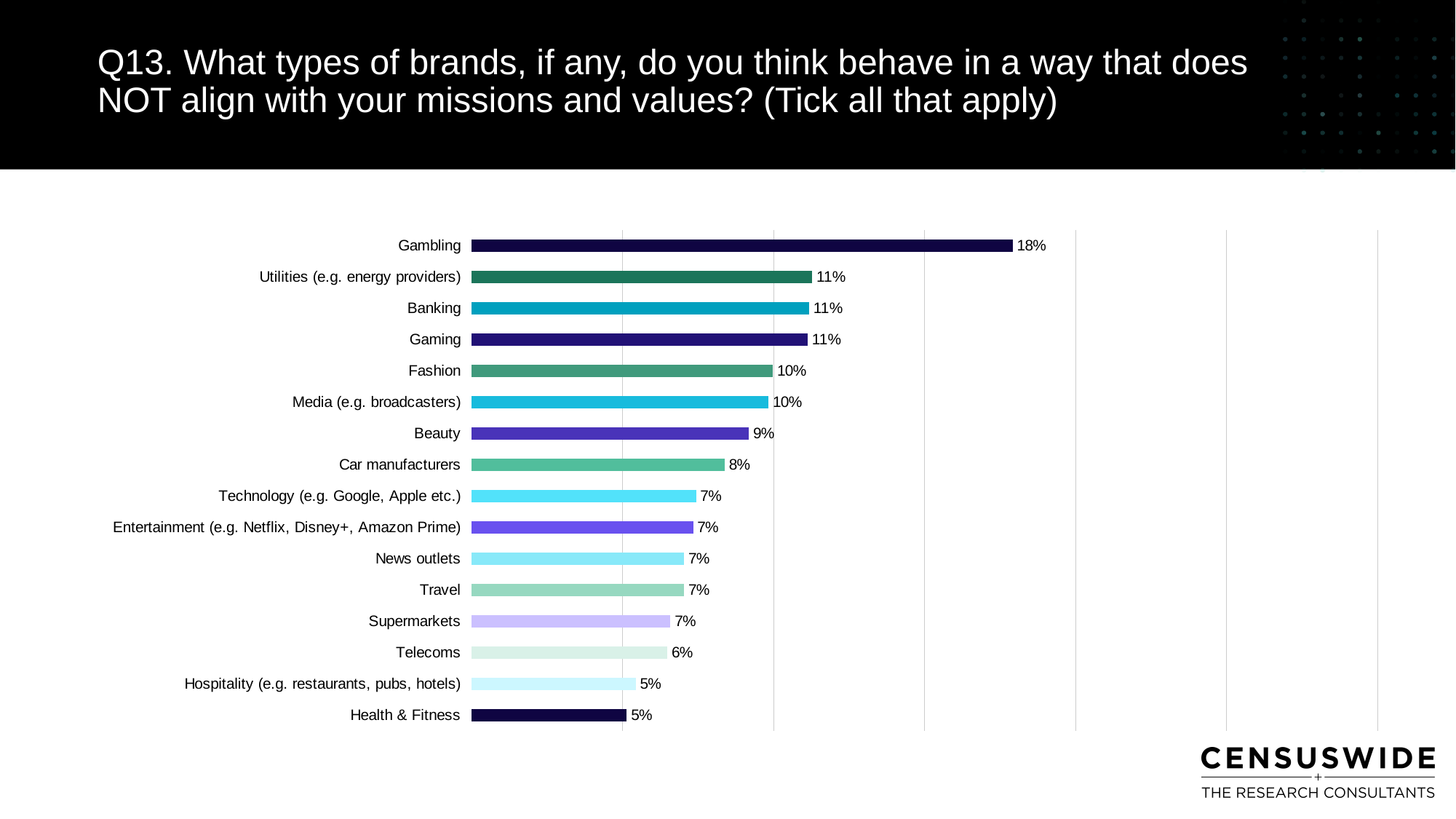
What is the difference between the values for Gambling and Fashion? 8% What is the value shown for Car manufacturers? 8% Which category is listed at the bottom of the chart? Health & Fitness How many brand categories are shown in the chart? 16 Which brand type has the highest percentage? Gambling Which is larger, the value for Media (e.g. broadcasters) or the value for Supermarkets? Media (e.g. broadcasters) What is the value for Beauty? 9% Which is larger, the value for Gaming or the value for Car manufacturers? Gaming What percentage of respondents selected Gambling? 18% What is the difference between the values for Banking and Health & Fitness? 6% What type of chart is shown on the slide? Bar chart What percentage is shown for Telecoms? 6%